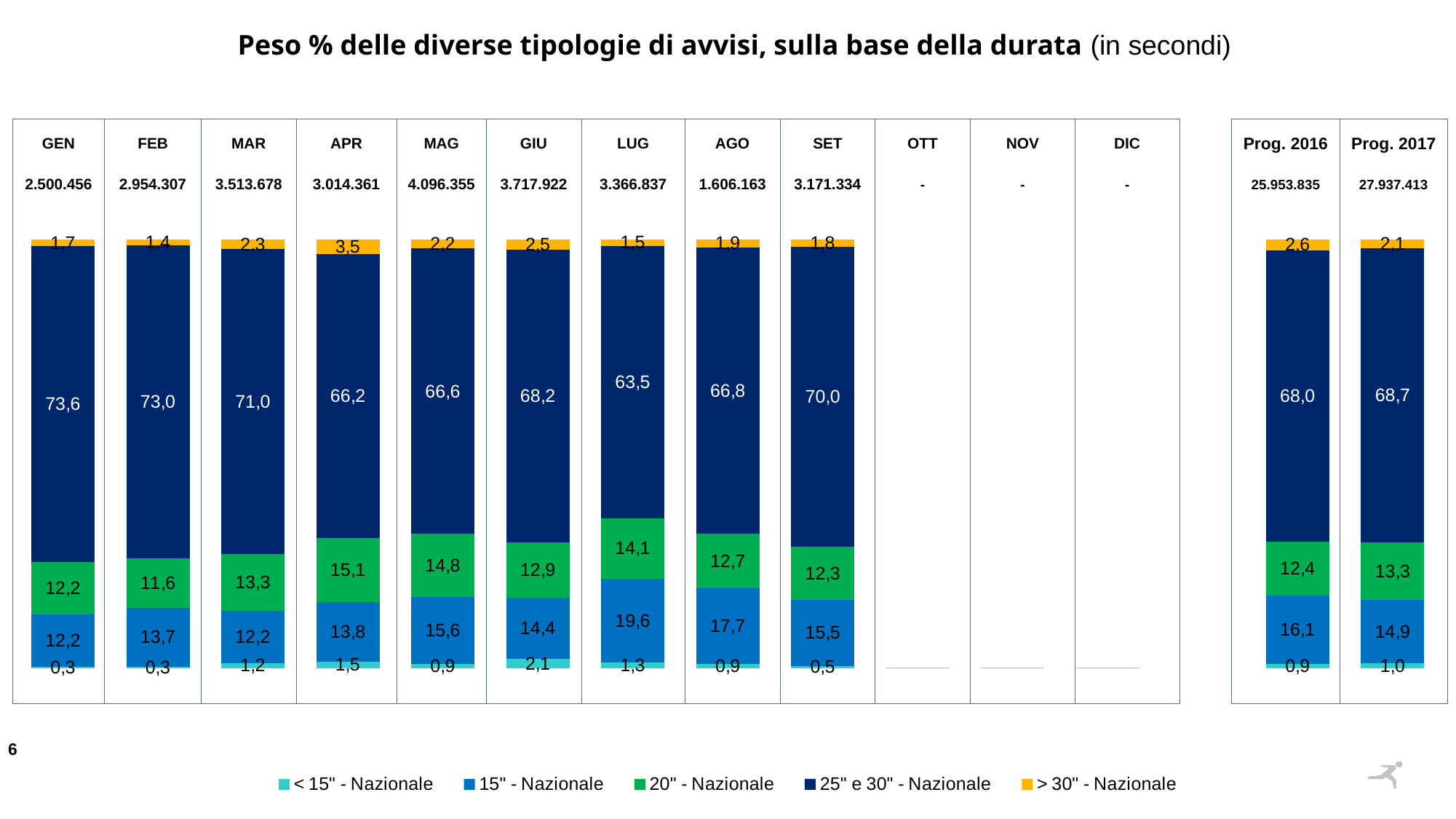
Which month has the highest value for the 25" e 30" - Nazionale segment? GEN Which month has the lowest value for the 25" e 30" - Nazionale segment? LUG Which is larger, the 15" - Nazionale value for AGO or for SET? AGO What is the value of the 15" - Nazionale segment for LUG? 19,6 How many months have data plotted in the chart? 9 What is the value of the 25" e 30" - Nazionale segment for GEN? 73,6 What is the difference between the 25" e 30" - Nazionale values for GEN and LUG? 10,1 What is the value of the 25" e 30" - Nazionale segment for Prog. 2017? 68,7 What is the value of the > 30" - Nazionale segment for APR? 3,5 What kind of chart is shown on the slide? Stacked bar chart Does the 25" e 30" - Nazionale value rise or fall from GEN to APR? Fall How many series does the legend list? 5